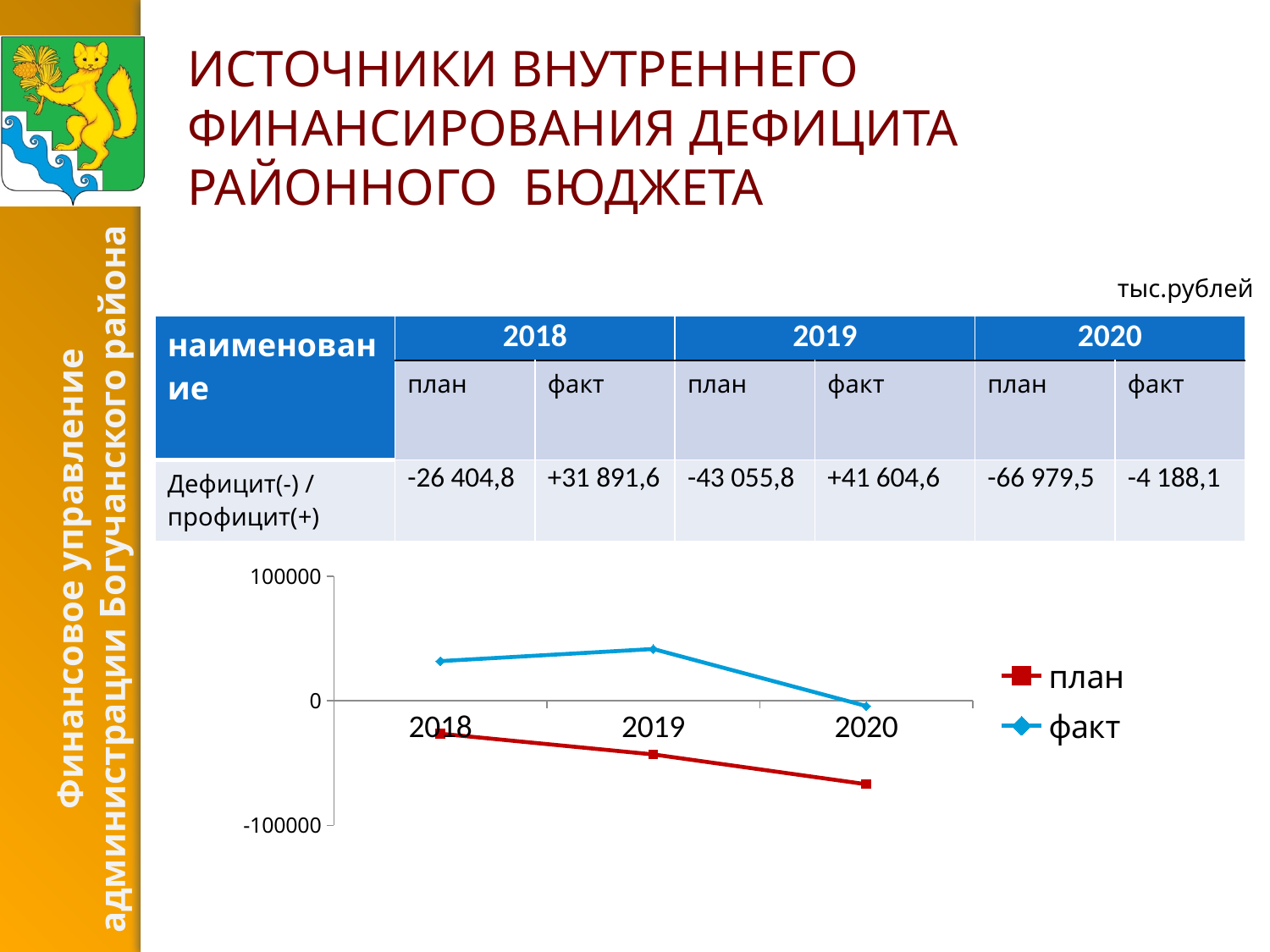
In which year does the план series reach its lowest value? 2020 Is the value of the факт series for 2019 greater or less than 0? greater Does the план series rise or fall from 2018 to 2020? fall How many series does the chart legend list? 2 How many years are plotted along the x axis of the chart? 3 Which series is drawn in red on the chart? план Is the value of the план series for 2020 greater or less than 0? less What is the факт value for 2020 (тыс.рублей), as shown in the table above the chart? -4 188,1 What kind of chart is shown on the slide? line chart For 2018, which is larger: the план value or the факт value? факт What is the план value for 2019 (тыс.рублей), as shown in the table above the chart? -43 055,8 In which year does the факт series reach its highest value? 2019